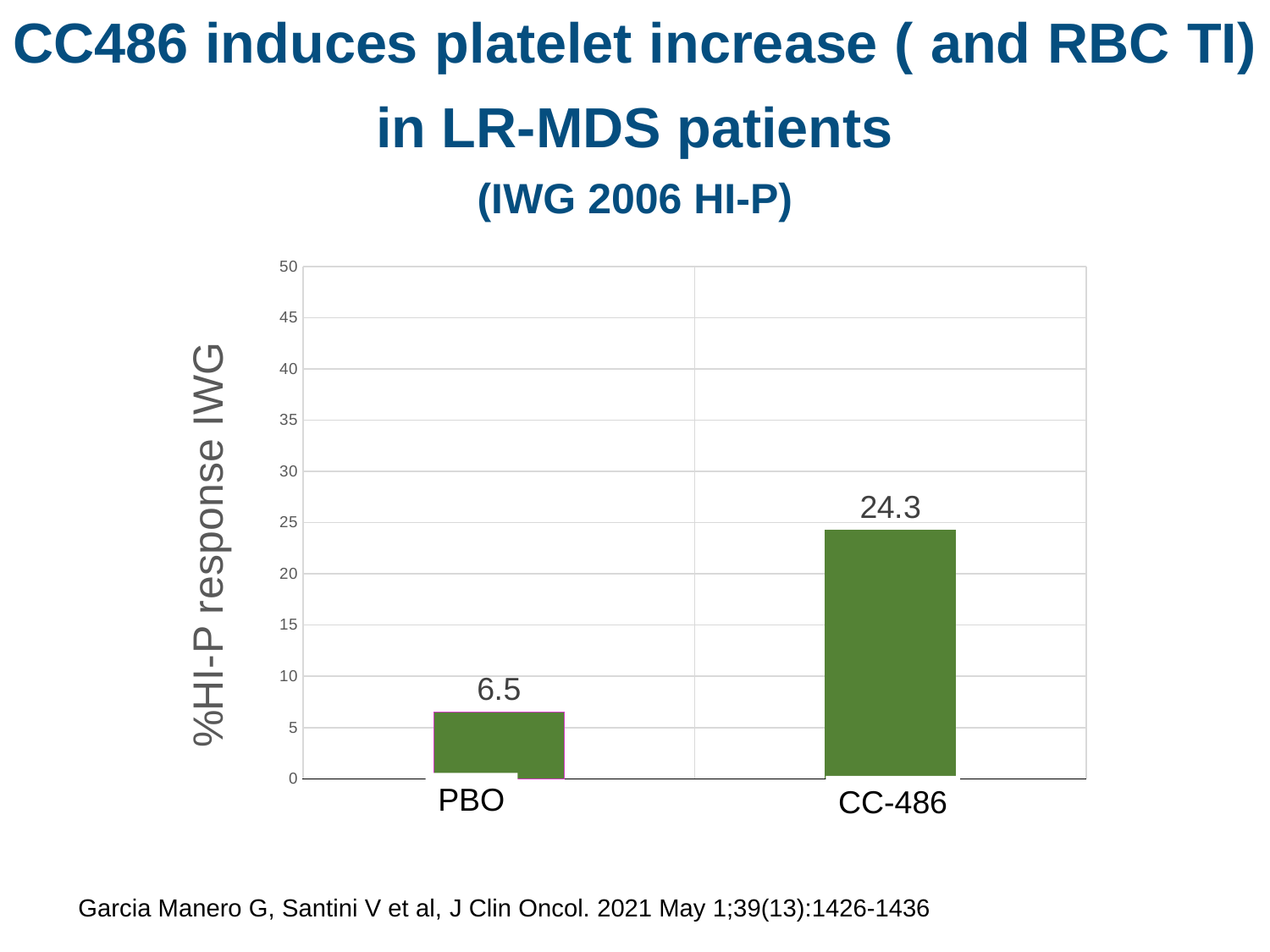
Which category has the highest %HI-P response? CC-486 What is the maximum value shown on the y axis? 50 What kind of chart is shown on the slide? bar chart Is the value for PBO greater or less than 10? less How many categories are shown on the x axis? 2 Is the value for CC-486 greater or less than 20? greater What is the %HI-P response value for PBO? 6.5 Which is larger, the value for PBO or the value for CC-486? CC-486 What is the %HI-P response value for CC-486? 24.3 What is the label of the y axis? %HI-P response IWG Which category has the lowest %HI-P response? PBO What is the difference between the CC-486 and PBO values? 17.8